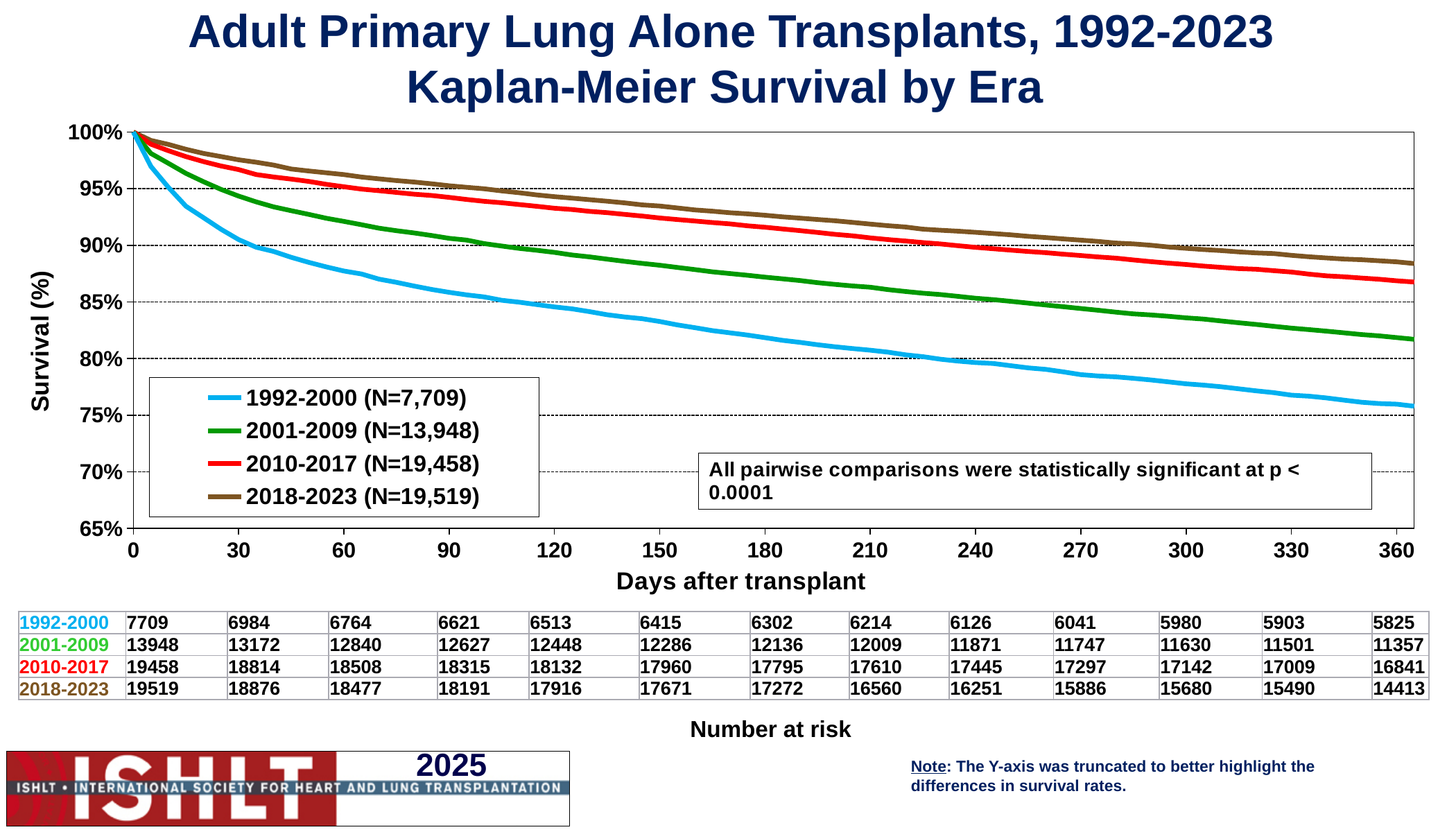
Is the survival value for the 2018-2023 era at 360 days greater or less than 85%? greater In the Number at risk table, what is the number at risk for the 2001-2009 era at 360 days? 11357 How many series (eras) does the legend list? 4 Is the survival value for the 1992-2000 era at 360 days greater or less than 80%? less At 180 days after transplant, which era has higher survival: 2001-2009 or 1992-2000? 2001-2009 What kind of chart is shown on the slide? line chart Do the survival curves rise or fall as days after transplant increase? fall Which era has the lowest survival at 360 days after transplant? 1992-2000 According to the legend, what is the difference between the N for the 2018-2023 era and the N for the 1992-2000 era? 11,810 Which era has the highest survival at 360 days after transplant? 2018-2023 What is the title of the chart? Adult Primary Lung Alone Transplants, 1992-2023 Kaplan-Meier Survival by Era According to the legend, what is the N for the 2010-2017 era? 19,458